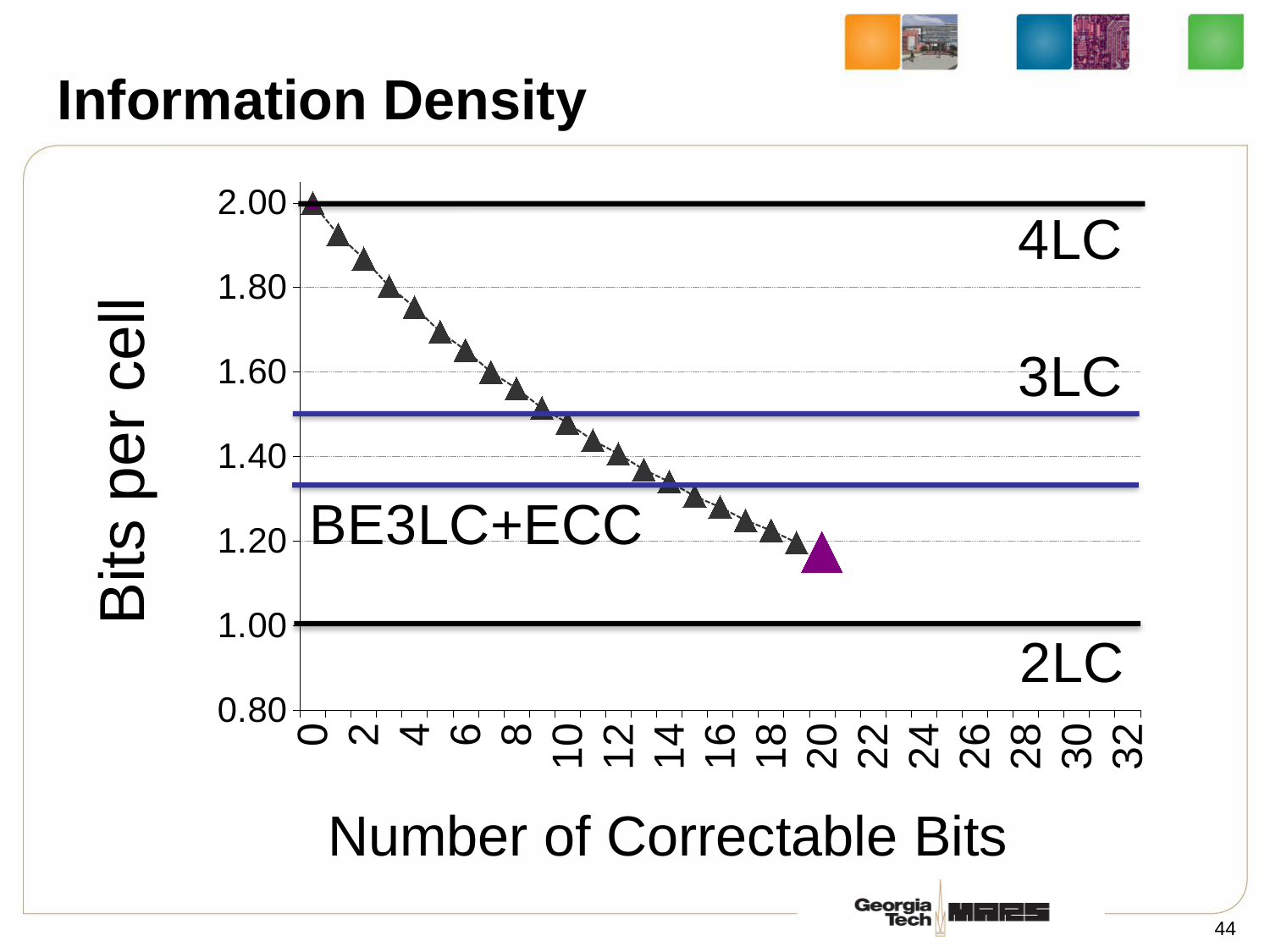
Which has the larger bits per cell value for BE3LC+ECC: 2 correctable bits or 18 correctable bits? 2 correctable bits Is the BE3LC+ECC value at 4 correctable bits greater or less than 1.60? greater What kind of chart is shown on the slide? line chart What is the bits per cell value of the BE3LC+ECC series at 0 correctable bits? 2.00 At what bits per cell value is the 4LC reference line drawn? 2.00 What is the label of the y axis? Bits per cell At what bits per cell value is the 2LC reference line drawn? 1.00 Is the BE3LC+ECC value at 10 correctable bits greater or less than 1.40? greater What is the title of the slide containing the chart? Information Density At which number of correctable bits does the BE3LC+ECC series reach its highest bits per cell value? 0 As the number of correctable bits increases, do the BE3LC+ECC bits per cell values rise or fall? fall Is the BE3LC+ECC value at 20 correctable bits greater or less than 1.40? less